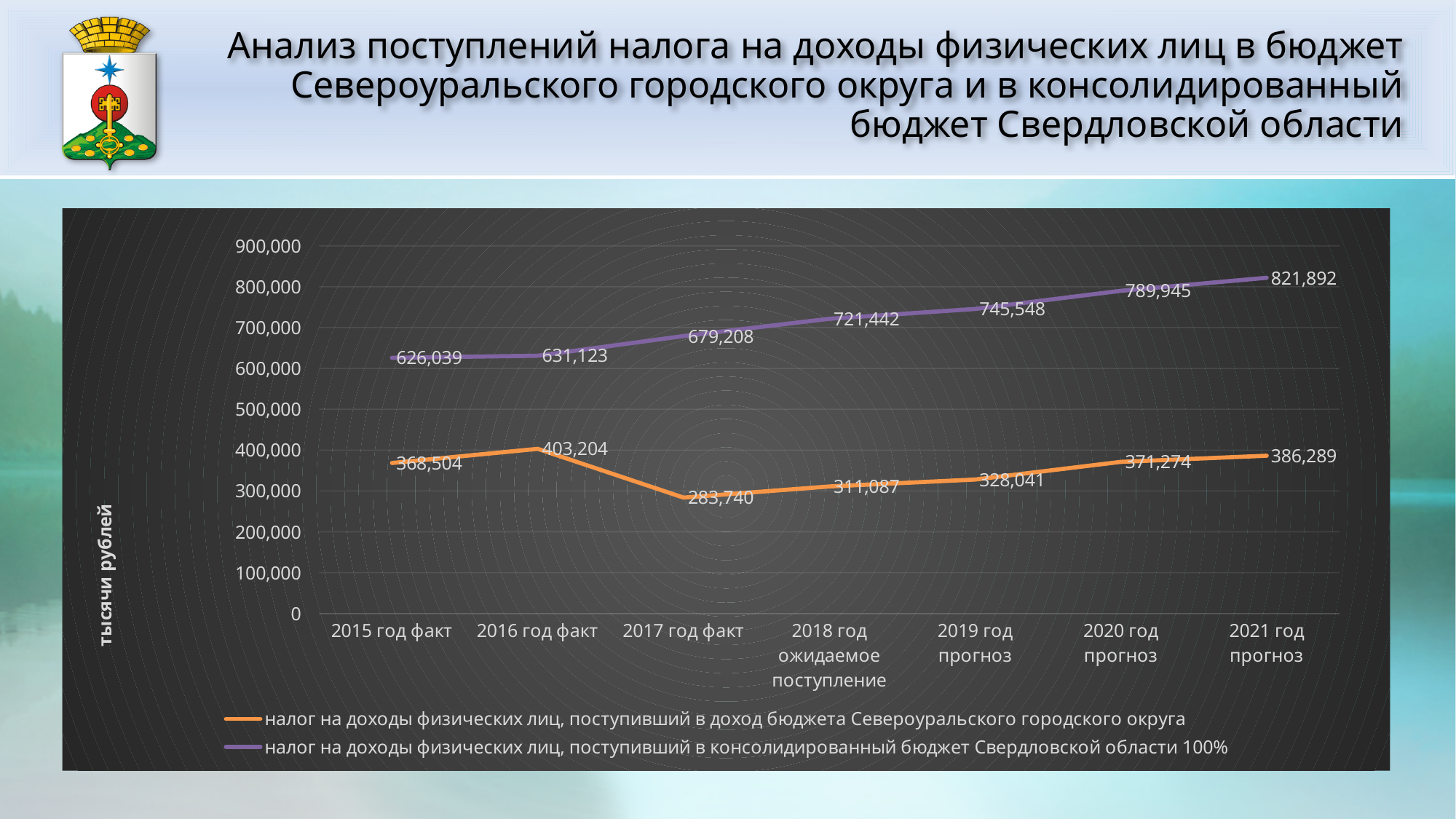
What is the value for 2015 год факт for the consolidated budget of Свердловская область series? 626,039 How many categories are shown on the x axis? 7 What kind of chart is shown on the slide? line chart Which is larger for 2019 год прогноз: the Североуральский городской округ value or the consolidated Свердловская область value? the consolidated Свердловская область value (745,548) Does the consolidated Свердловская область series rise or fall from 2015 год факт to 2021 год прогноз? rise How many series does the legend list? 2 What is the value for 2017 год факт for the series 'налог на доходы физических лиц, поступивший в доход бюджета Североуральского городского округа'? 283,740 By how much did the Североуральский городской округ series fall from 2016 год факт to 2017 год факт? 119,464 What is the difference between the two series' values for 2021 год прогноз? 435,603 In which category does the Североуральский городской округ series reach its lowest value? 2017 год факт In which category does the Североуральский городской округ series reach its highest value? 2016 год факт What is the value for 2021 год прогноз for the series 'налог на доходы физических лиц, поступивший в консолидированный бюджет Свердловской области 100%'? 821,892